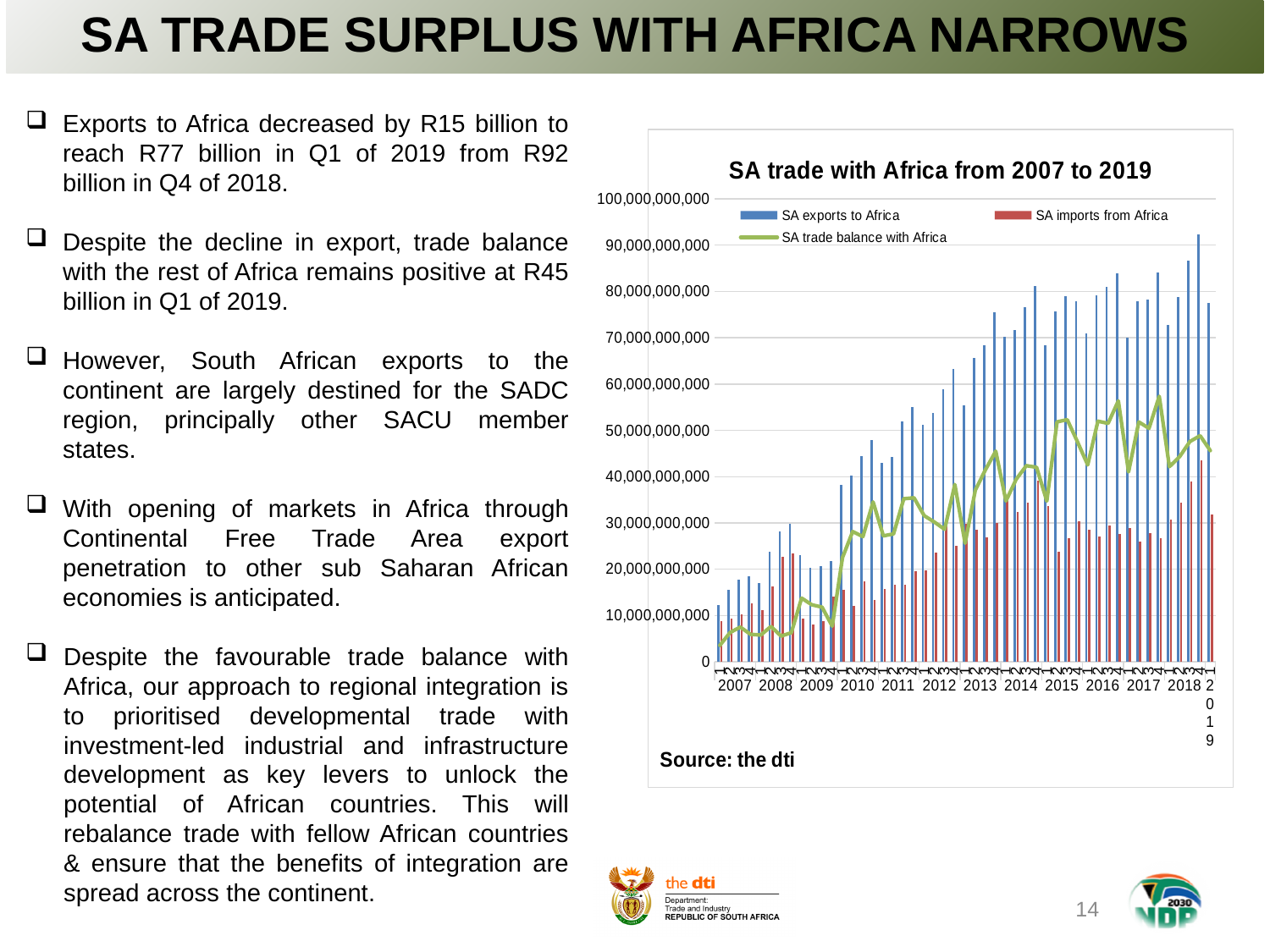
Is the first SA exports to Africa bar in 2007 greater or less than 20,000,000,000? less What is the title of the chart? SA trade with Africa from 2007 to 2019 How many series does the chart legend list? 3 In the last quarter of 2018, which is larger: SA exports to Africa or SA imports from Africa? SA exports to Africa What kind of chart is shown on the slide? A combined bar and line chart Overall, do SA exports to Africa rise or fall from 2007 to 2018? rise Which series is plotted as a green line in the chart? SA trade balance with Africa What is the highest value shown on the chart's vertical axis? 100,000,000,000 Is the highest point of the SA trade balance with Africa line greater or less than 50,000,000,000? greater In which year does the tallest SA exports to Africa bar appear? 2018 Is the tallest SA exports to Africa bar greater or less than 90,000,000,000? greater How many years are labelled along the x axis of the chart? 13